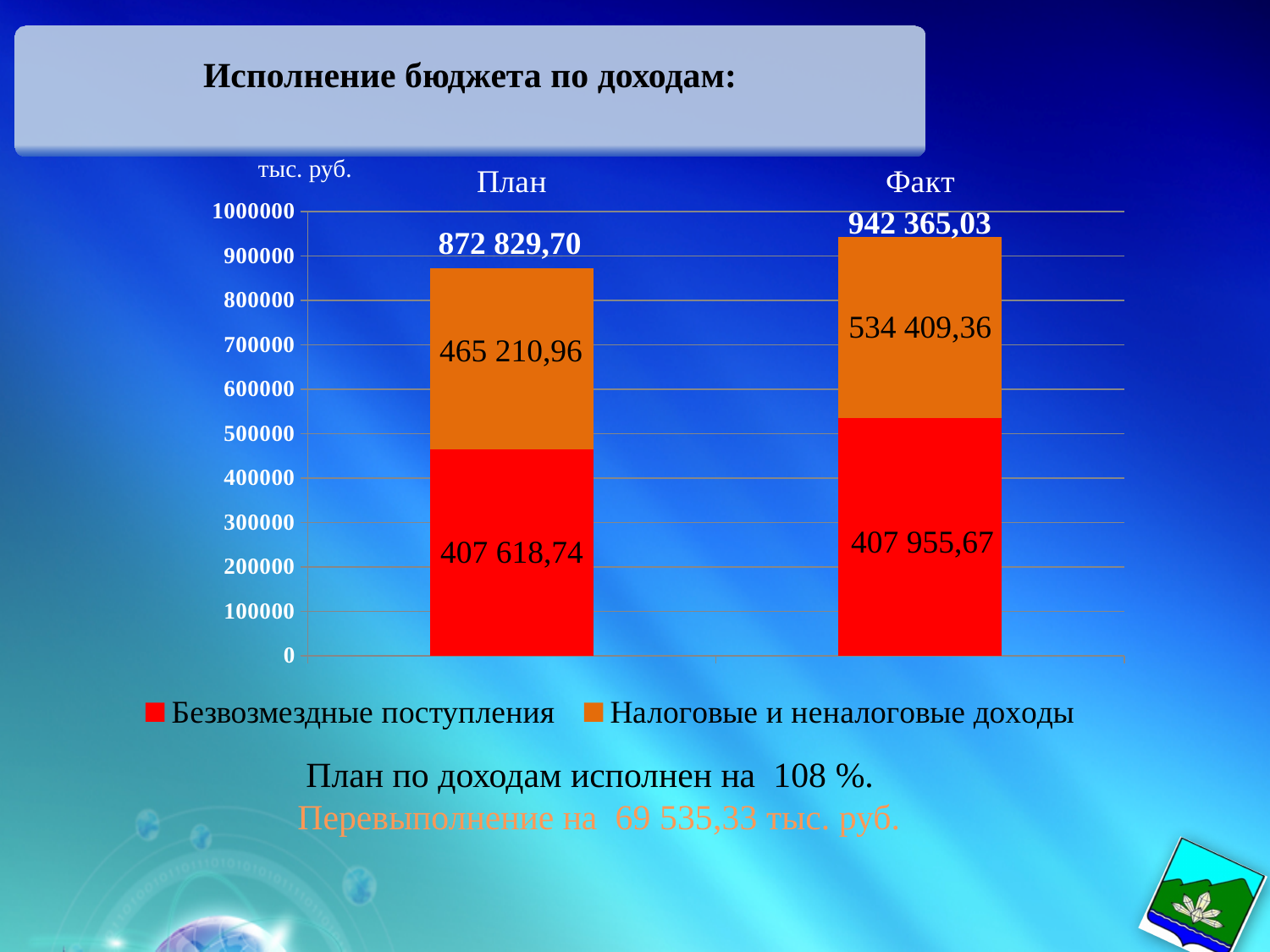
Which colour represents Безвозмездные поступления in the chart? red What is the value of Безвозмездные поступления for Факт? 407 955,67 What is the total of the stacked bar for План? 872 829,70 What is the difference between the total for Факт and the total for План? 69 535,33 What is the difference between the Налоговые и неналоговые доходы values for Факт and План? 69 198,40 Which category has the higher total, План or Факт? Факт How many series does the legend list? 2 What is the total of the stacked bar for Факт? 942 365,03 What type of chart is shown on the slide? stacked bar chart What is the value of Налоговые и неналоговые доходы for Факт? 534 409,36 What is the value of Налоговые и неналоговые доходы for План? 465 210,96 How many categories are shown on the x axis? 2